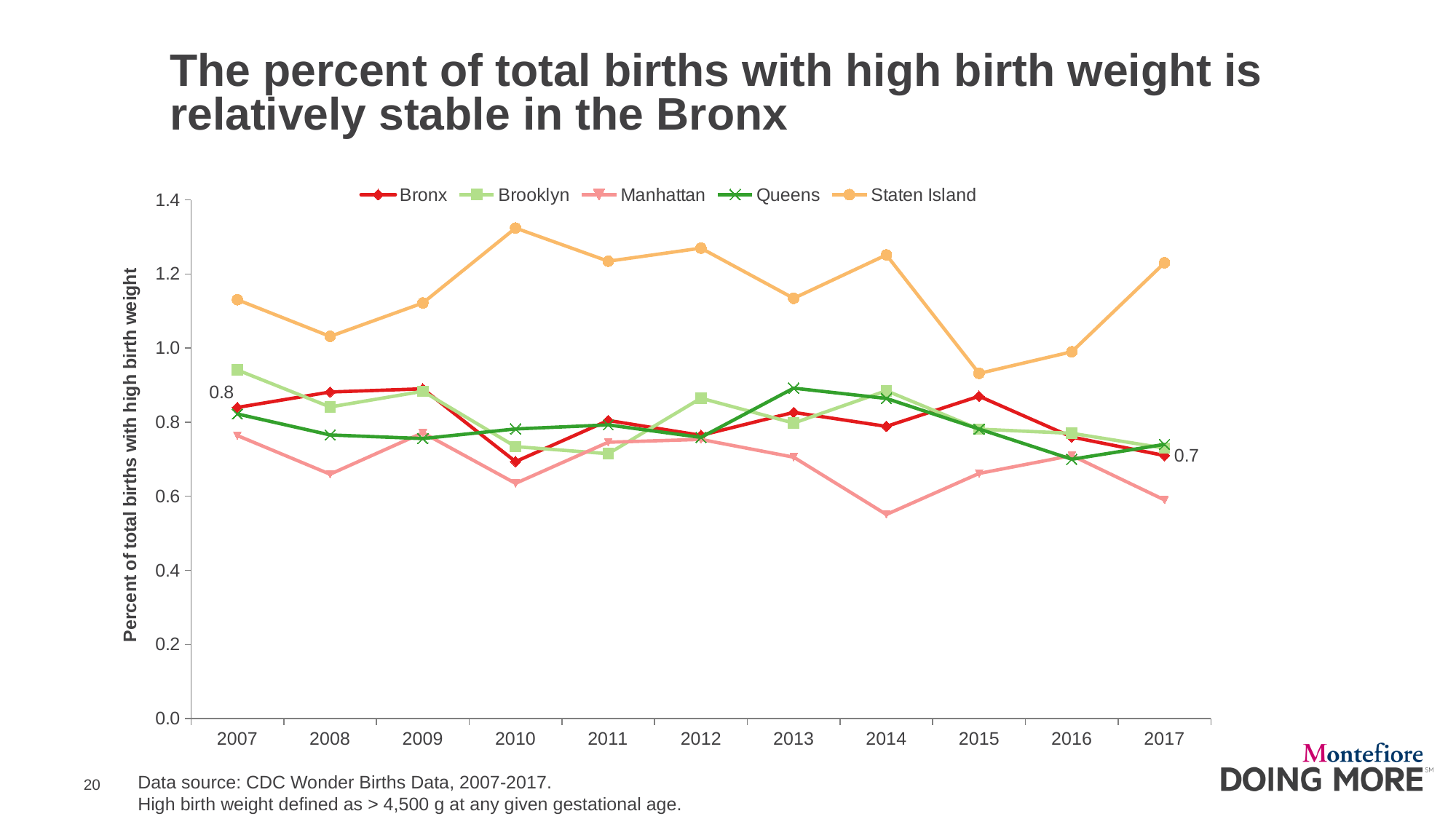
How many series does the legend list? 5 Is the value for Manhattan in 2014 greater or less than 0.6? less Which borough has the highest value in 2010? Staten Island What is the title of the y axis? Percent of total births with high birth weight Is the value for Staten Island in 2010 greater or less than 1.2? greater What type of chart is shown on the slide? Line chart How many years are plotted along the x axis? 11 What is the labelled value for the Bronx in 2007? 0.8 Which is larger in 2017, the value for Staten Island or the value for Manhattan? Staten Island By how much did the Bronx value fall from 2007 to 2017, using the printed labels? 0.1 What is the labelled value for the Bronx in 2017? 0.7 Which borough has the lowest value in 2014? Manhattan